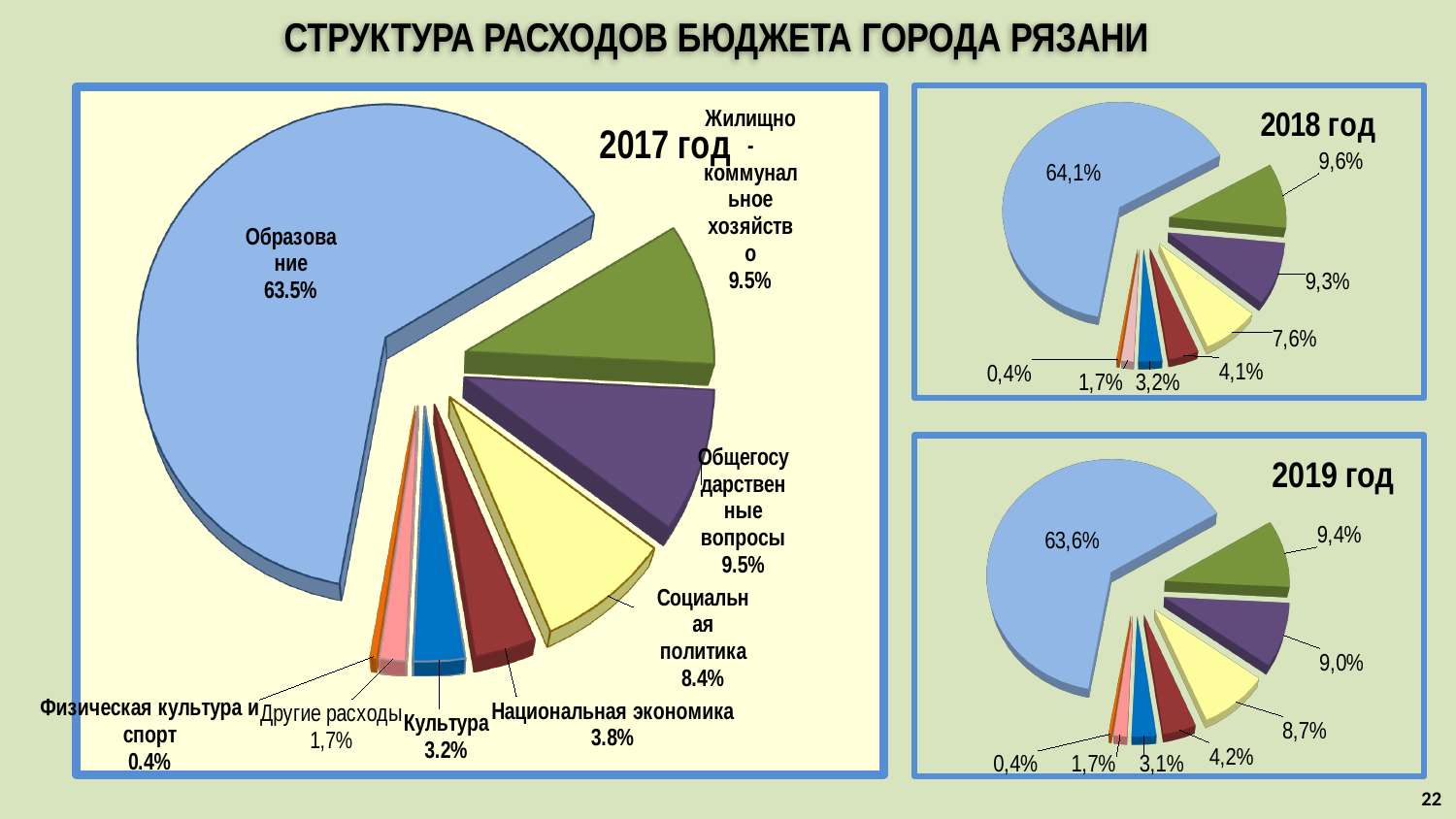
In the 2017 год pie chart, what share of the budget goes to Образование? 63.5% In the 2017 год pie chart, what is the difference between Социальная политика and Культура? 5.2% In the 2017 год pie chart, which category has the smallest share? Физическая культура и спорт What type of chart is used for the 2018 год data? Pie chart In the 2017 год pie chart, what is the value for Социальная политика? 8.4% What is the title of the slide containing the three pie charts? СТРУКТУРА РАСХОДОВ БЮДЖЕТА ГОРОДА РЯЗАНИ In the 2017 год pie chart, which category has the largest share? Образование In the 2017 год pie chart, which is larger: Национальная экономика or Другие расходы? Национальная экономика In the 2018 год pie chart, what is the value of the largest slice? 64,1% In the 2019 год pie chart, what is the value of the smallest slice? 0,4% How many slices does the 2017 год pie chart have? 8 In the 2017 год pie chart, what is the value for Национальная экономика? 3.8%